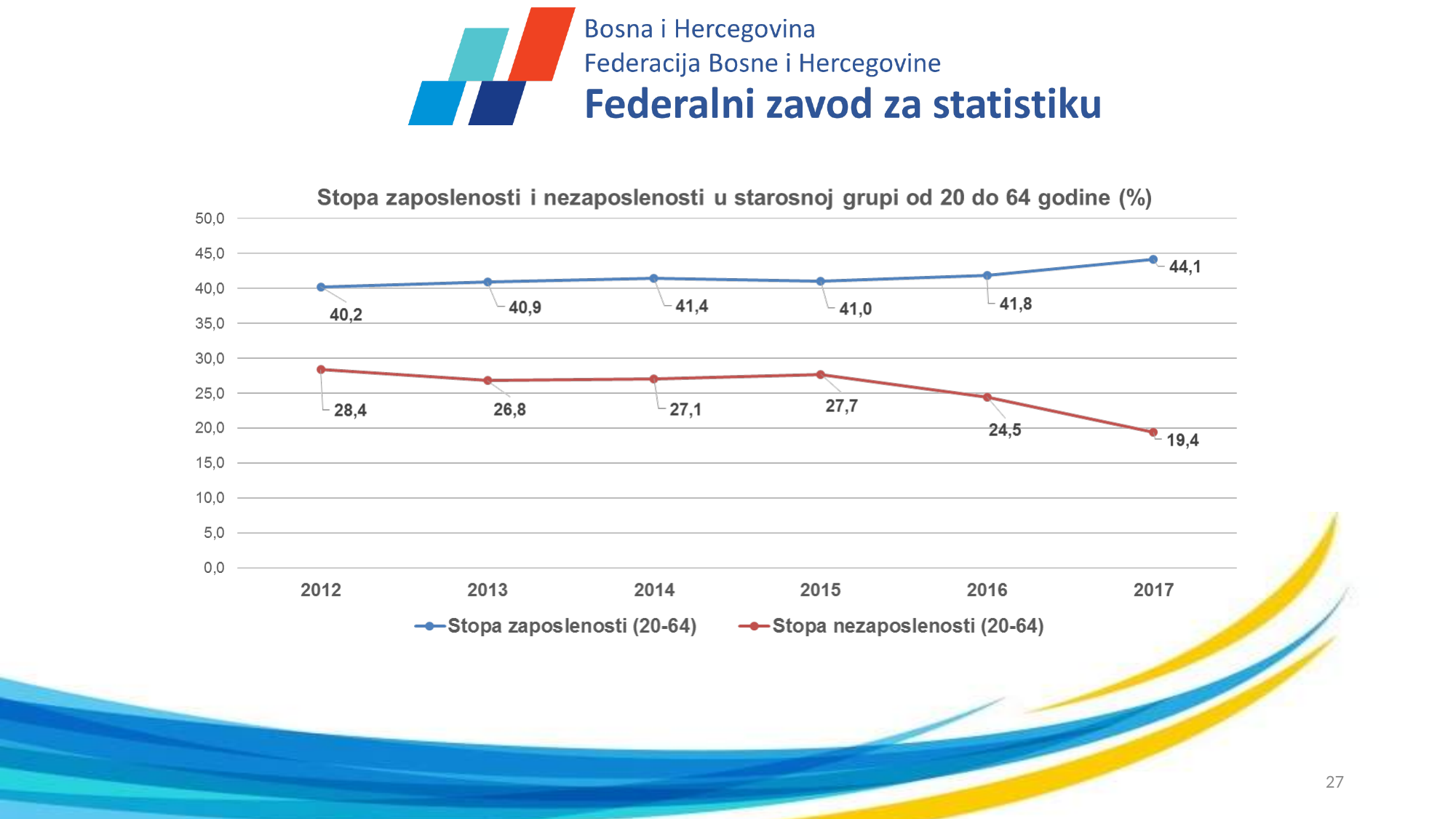
What is the title of the chart? Stopa zaposlenosti i nezaposlenosti u starosnoj grupi od 20 do 64 godine (%) What kind of chart is shown on the slide? line chart What is the difference between Stopa zaposlenosti (20-64) and Stopa nezaposlenosti (20-64) in 2017? 24,7 Which is larger: Stopa nezaposlenosti (20-64) in 2013 or in 2016? 2013 In which year is Stopa zaposlenosti (20-64) highest? 2017 What is the value of Stopa zaposlenosti (20-64) in 2017? 44,1 How many series does the legend list? 2 What is the value of Stopa nezaposlenosti (20-64) in 2012? 28,4 Does Stopa nezaposlenosti (20-64) rise or fall from 2015 to 2017? fall How many years are shown on the x axis? 6 In which year is Stopa nezaposlenosti (20-64) lowest? 2017 What is the value of Stopa nezaposlenosti (20-64) in 2015? 27,7